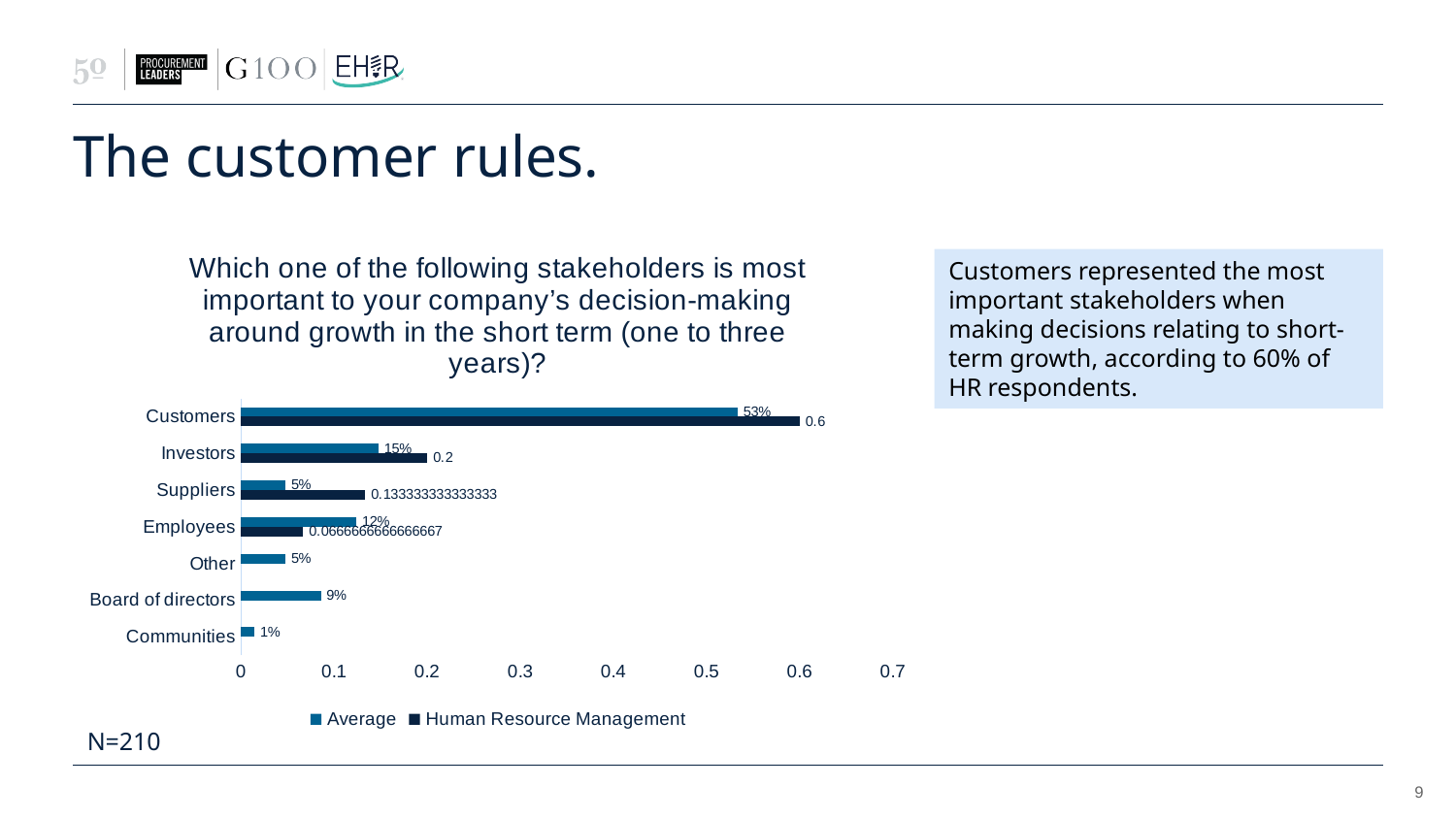
What type of chart is shown on the slide? Bar chart Which is larger, the Average value for Employees or the Average value for Board of directors? Employees What is the difference between the Average values for Investors and Employees? 3% How many series does the chart legend list? 2 Which category has the lowest Average value? Communities How many stakeholder categories are shown on the chart? 7 What is the Average value for Customers? 53% What is the Average value for Board of directors? 9% Which category has the highest Average value? Customers What is the Average value for Investors? 15% What is the Human Resource Management value for Customers? 0.6 What is the Human Resource Management value for Suppliers? 0.133333333333333